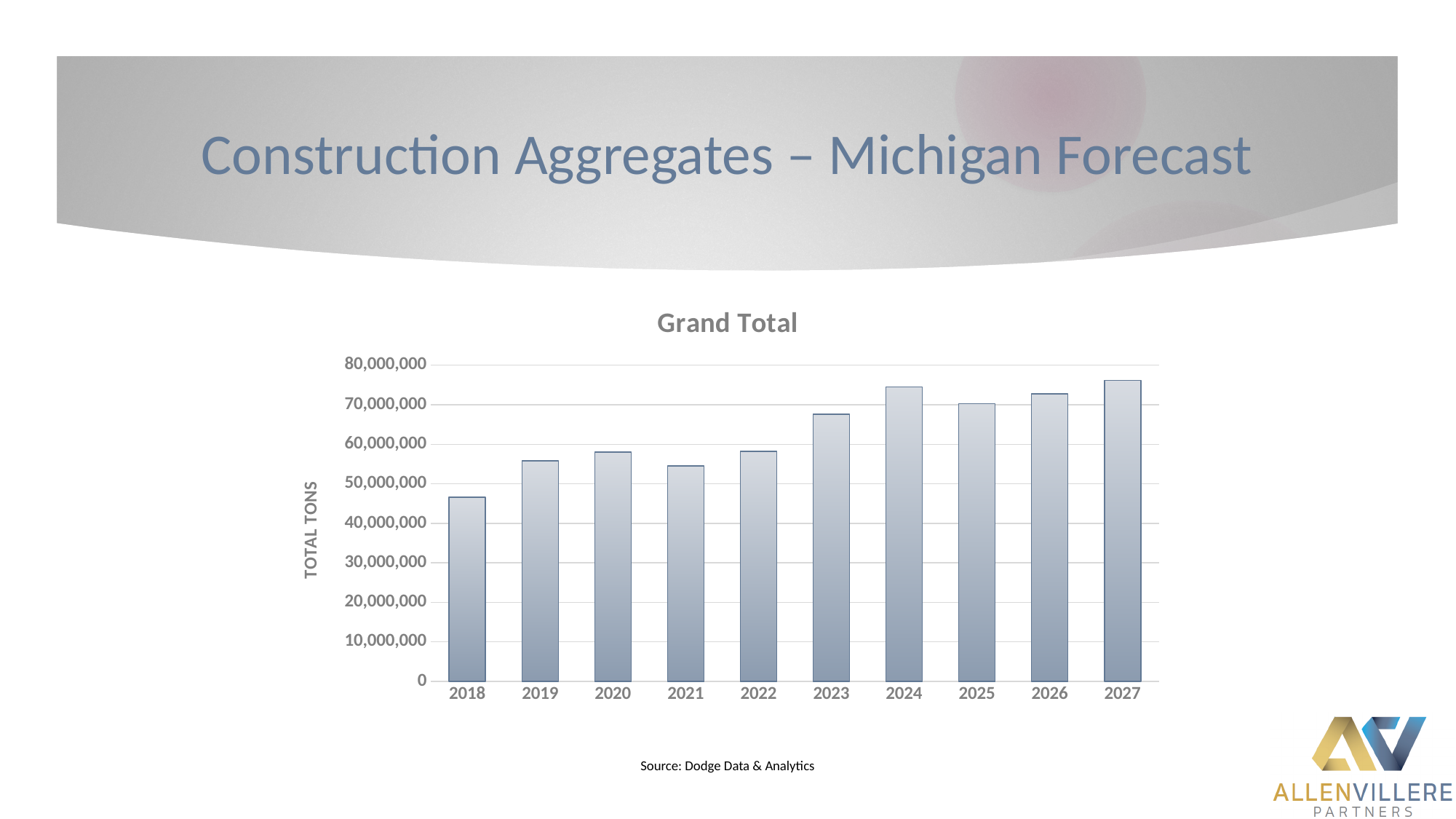
What is the label on the vertical axis of the chart? TOTAL TONS Which year has the highest total tons? 2027 Overall, do the values rise or fall from 2018 to 2027? rise Is the value for 2024 greater or less than 70,000,000? greater What is the title of the chart? Grand Total Is the value for 2018 greater or less than 50,000,000? less Which year has the lowest total tons? 2018 Which year has the larger value, 2024 or 2025? 2024 Is the value for 2020 greater or less than 60,000,000? less What kind of chart is shown on the slide? bar chart How many years are shown on the x axis of the chart? 10